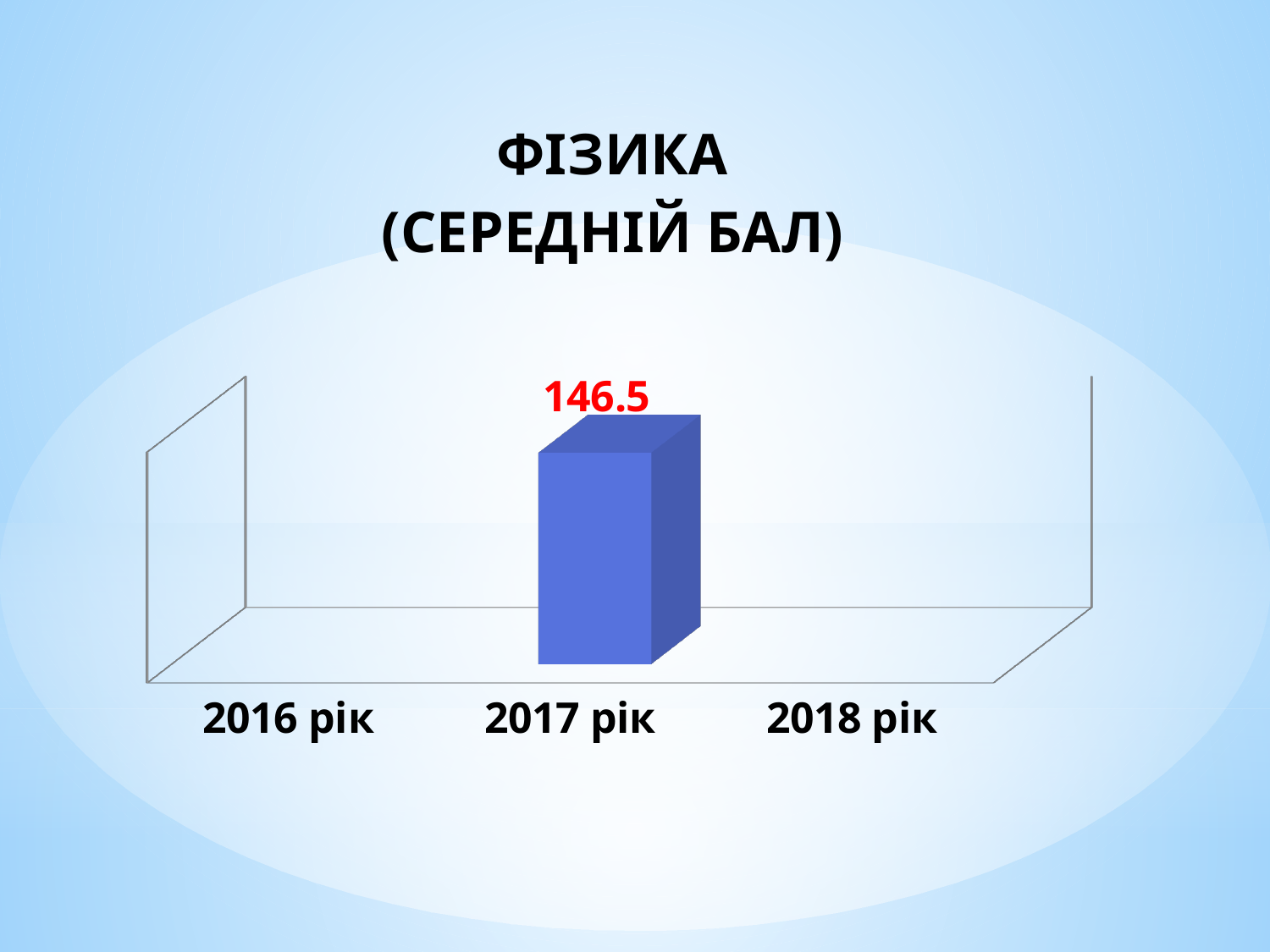
What is the title of the chart? ФІЗИКА (СЕРЕДНІЙ БАЛ) How many categories are shown on the x axis? 3 How many bars are plotted on the chart? 1 What is the last category label on the x axis? 2018 рік What is the first category label on the x axis? 2016 рік What is the value shown for 2017 рік? 146.5 Which year is the only one with a plotted bar? 2017 рік What kind of chart is shown on the slide? bar chart Which category has the highest value on the chart? 2017 рік